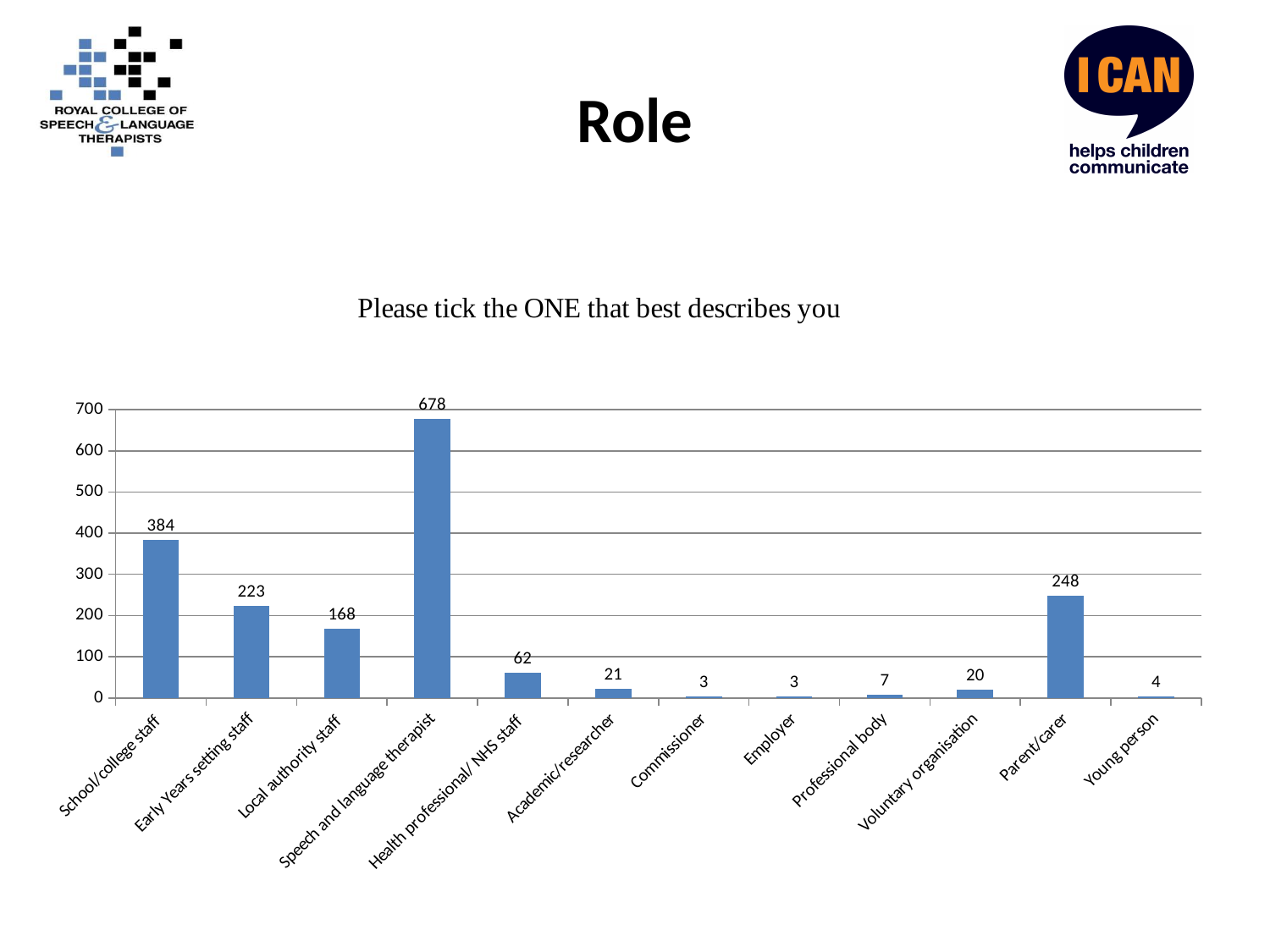
What kind of chart is shown on the slide? bar chart What is the value for Voluntary organisation? 20 What is the difference between the values for School/college staff and Early Years setting staff? 161 What is the value for Health professional/ NHS staff? 62 What is the difference between the values for Speech and language therapist and Parent/carer? 430 How many categories are shown on the x axis? 12 Is the value for School/college staff greater or less than 300? greater Which is larger, the value for Local authority staff or the value for Parent/carer? Parent/carer What is the title of the slide containing the chart? Role What is the value for Speech and language therapist? 678 Which category has the highest value? Speech and language therapist What is the value for Parent/carer? 248